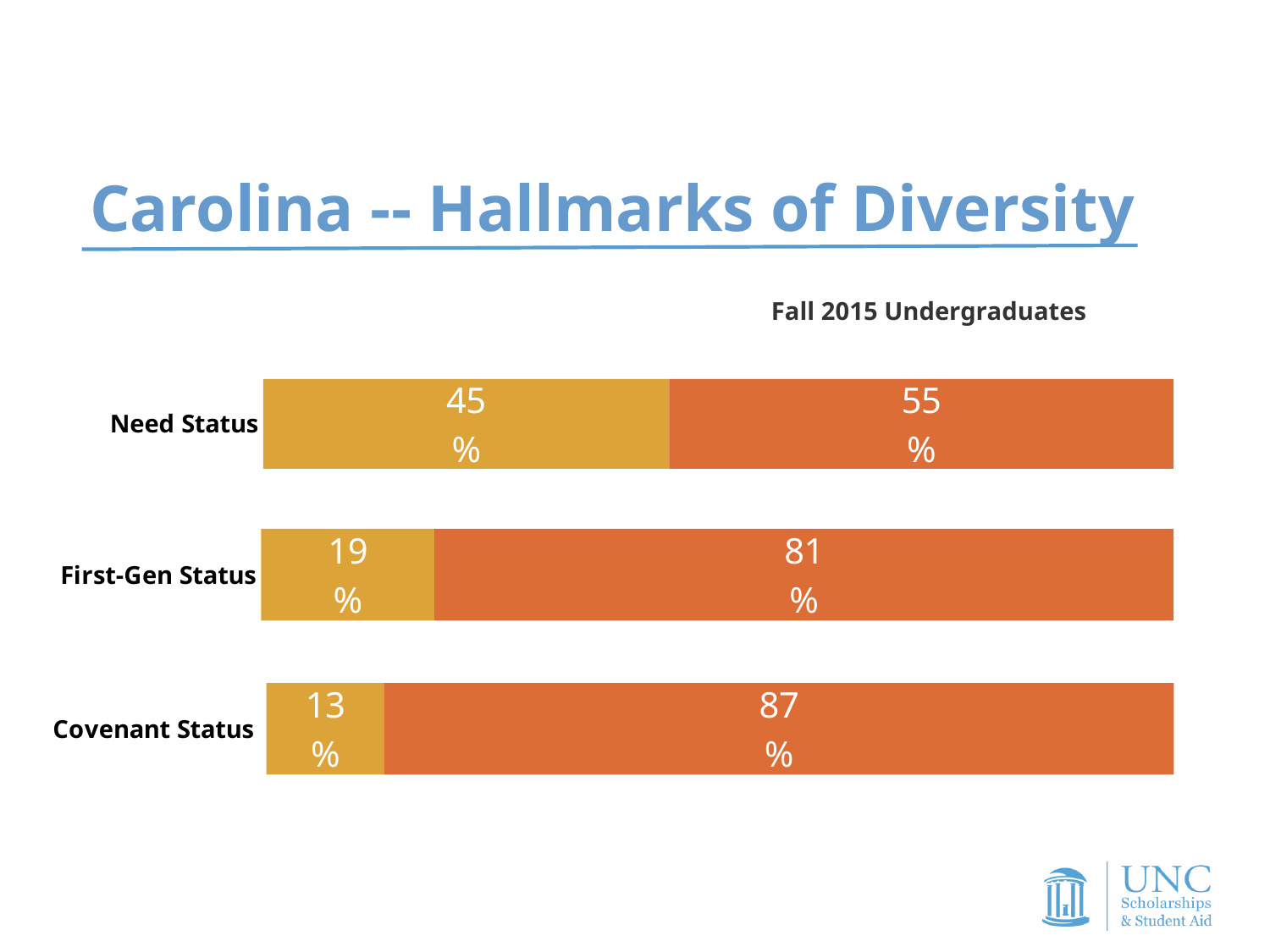
What is the value of the orange (right) segment for Covenant Status? 87% What is the total of the two segments in the Covenant Status bar? 100% Is the gold (left) segment for First-Gen Status larger than the gold (left) segment for Covenant Status? Yes What is the value of the gold (left) segment for Need Status? 45% What is the value of the orange (right) segment for Need Status? 55% What kind of chart is shown on the slide? bar chart Which category has the largest gold (left) segment? Need Status What is the title of the chart? Fall 2015 Undergraduates Which category has the smallest gold (left) segment? Covenant Status What is the difference between the orange segment and the gold segment for First-Gen Status? 62% How many categories are shown in the chart? 3 What is the value of the gold (left) segment for First-Gen Status? 19%